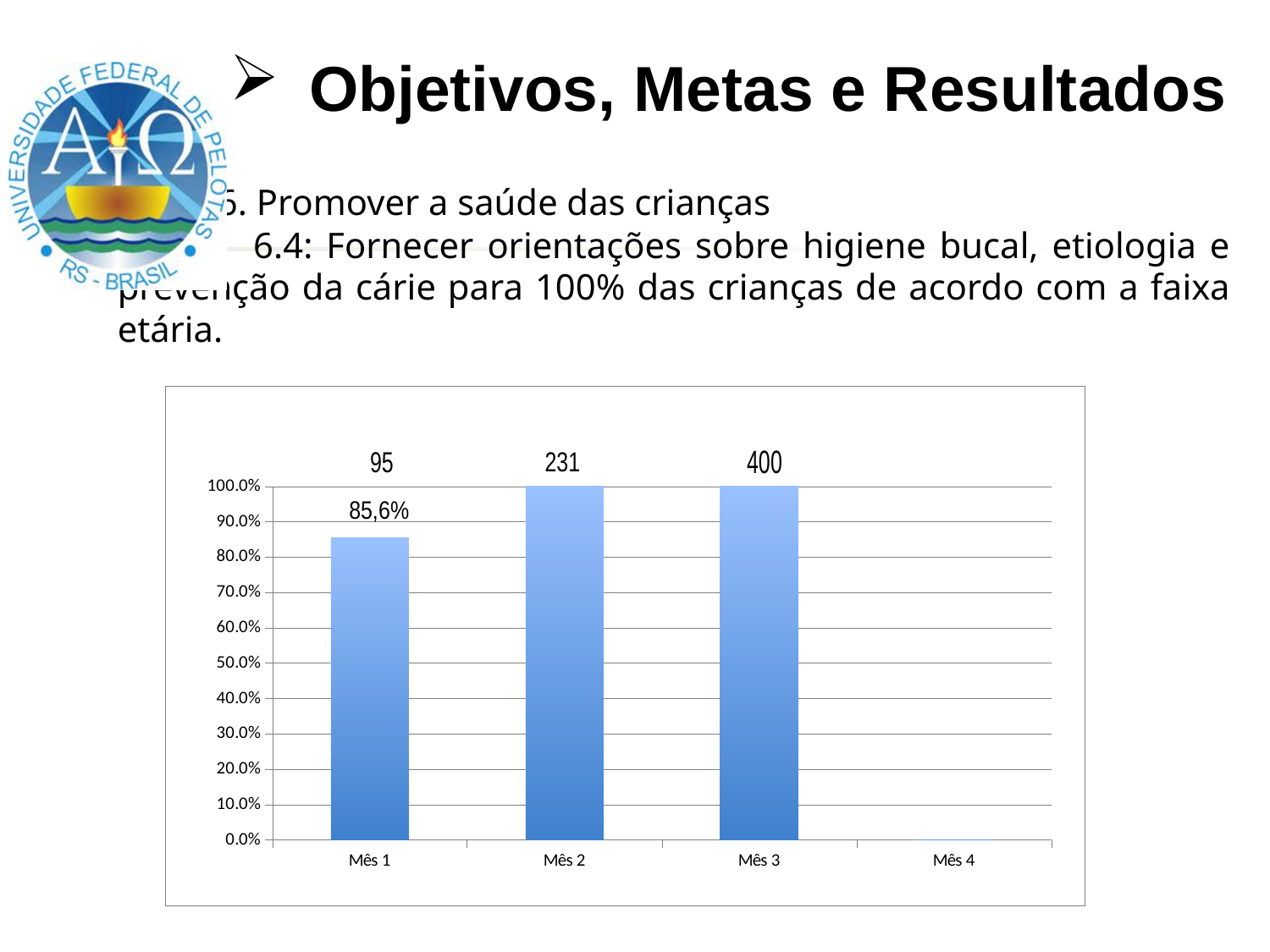
What is the value for Mês 3 in the chart? 100.0% What kind of chart is shown on the slide? bar chart What is the value for Mês 2 in the chart? 100.0% Is the value for Mês 4 greater or less than 10.0%? less Is the value for Mês 1 greater or less than 80.0%? greater Does the value rise or fall from Mês 1 to Mês 2? rise How many categories (months) are shown on the x axis of the chart? 4 What is the value for Mês 1 in the chart? 85,6% Which month has the lowest value in the chart? Mês 4 What number is printed above the bar for Mês 1? 95 What number is printed above the bar for Mês 3? 400 Which is larger in the chart, the value for Mês 1 or the value for Mês 2? Mês 2